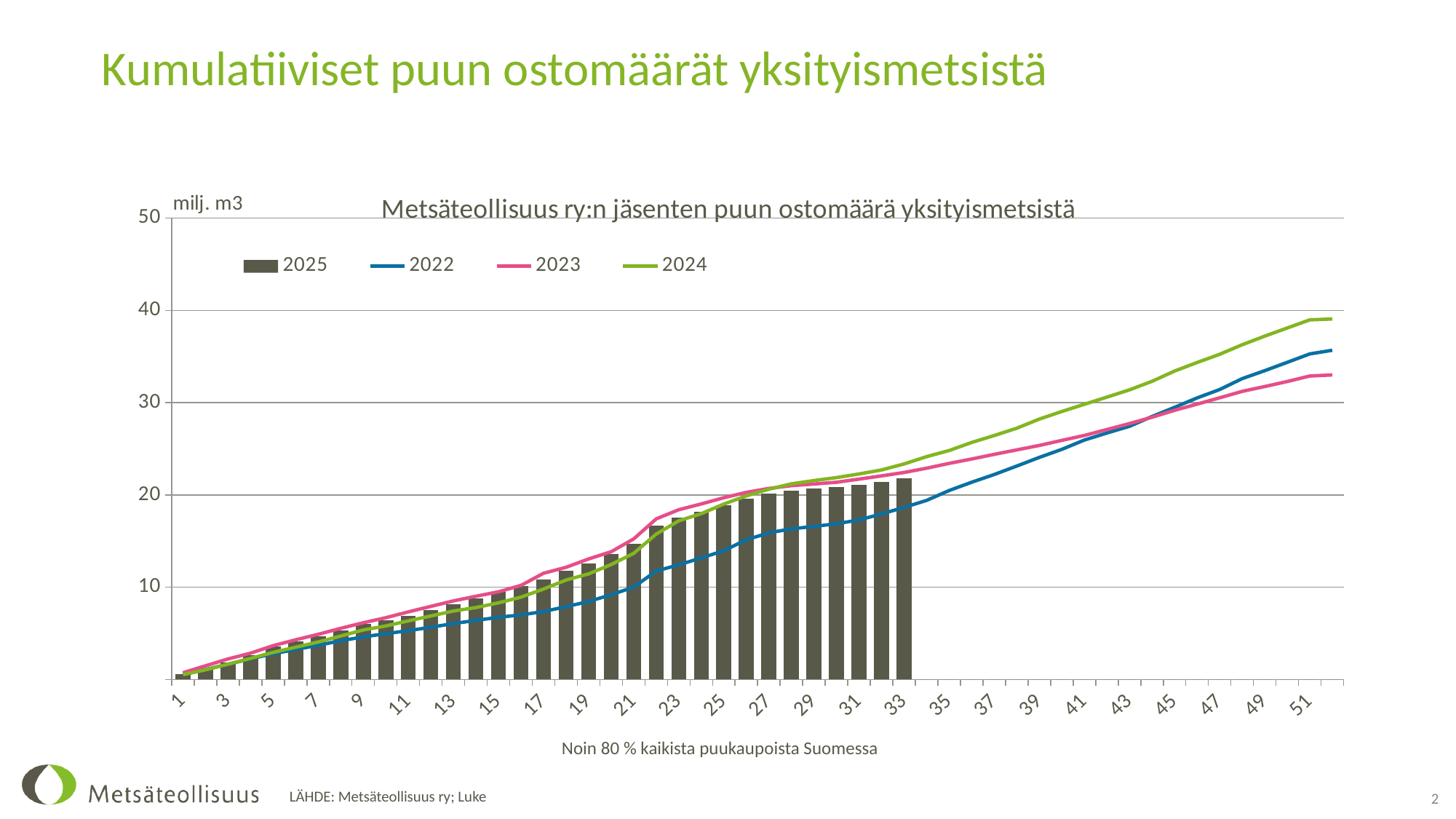
At week 33, which is larger: the 2025 bar or the 2022 line? 2025 Which series has the highest value at week 51? 2024 Is the value of the 2024 line at week 51 greater or less than 30? greater At week 41, which is larger: the 2024 line or the 2022 line? 2024 Do the values of the 2024 line rise or fall along the x axis? rise What kind of chart is shown on the slide? A combined bar and line chart Is the value of the 2022 line at week 33 greater or less than 20? less How many series does the chart legend list? 4 Which series has the lowest value at week 51? 2023 Is the 2025 bar at week 21 greater or less than 10? greater Which series is drawn as bars rather than a line? 2025 What is the title of the chart? Metsäteollisuus ry:n jäsenten puun ostomäärä yksityismetsistä